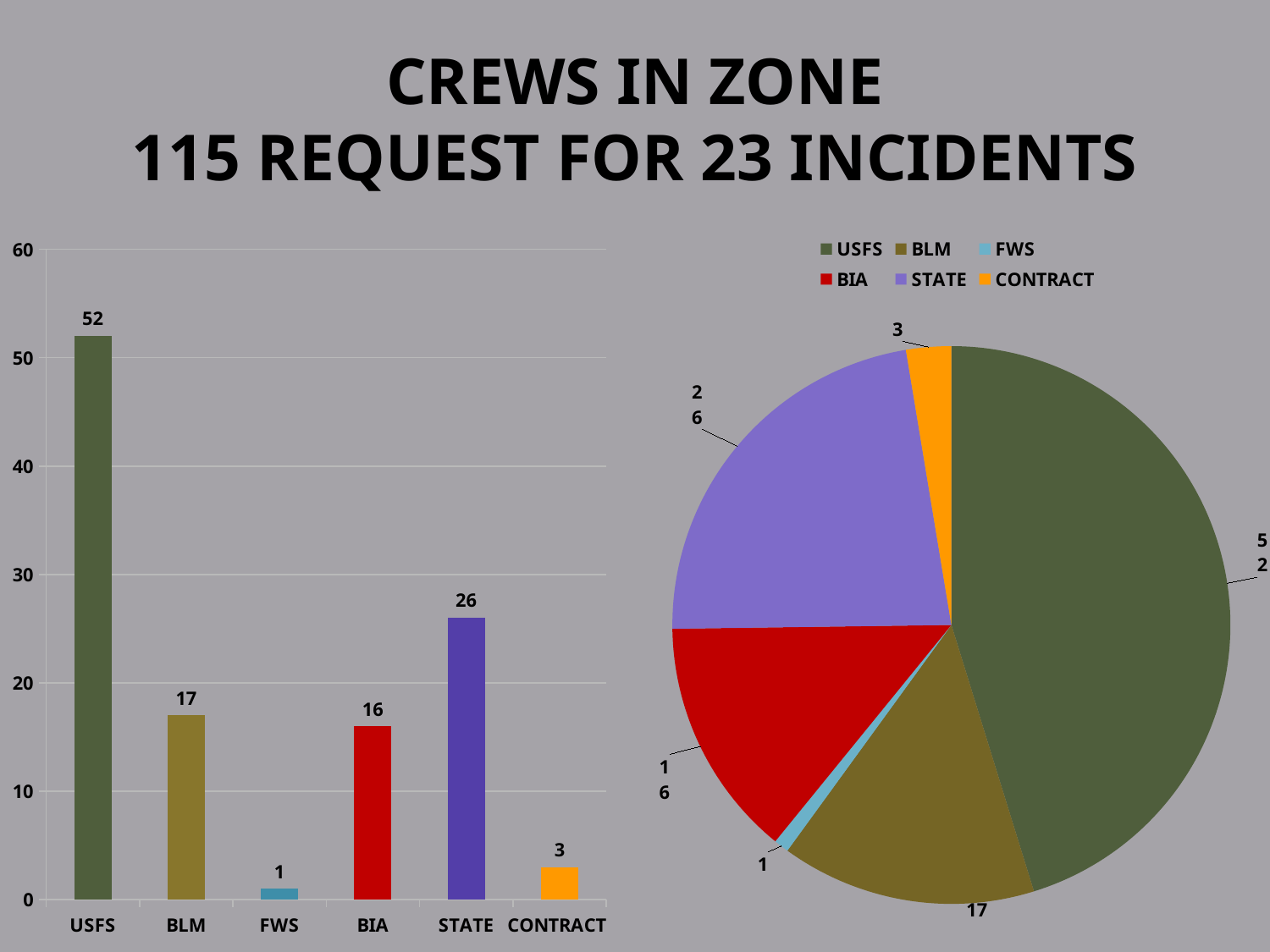
In the bar chart on the left, is the value for STATE greater or less than 20? greater How many entries does the legend of the pie chart on the right list? 6 In the bar chart on the left, what is the value for STATE? 26 What kind of chart is on the left side of the slide? bar chart How many categories are shown in the bar chart on the left? 6 In the bar chart on the left, what is the difference between the values for USFS and STATE? 26 What kind of chart is on the right side of the slide? pie chart In the bar chart on the left, what is the value for USFS? 52 In the bar chart on the left, which category has the lowest value? FWS In the bar chart on the left, which is larger, the value for BLM or the value for BIA? BLM In the pie chart on the right, what is the value labelled for the CONTRACT slice? 3 In the bar chart on the left, which category has the highest value? USFS